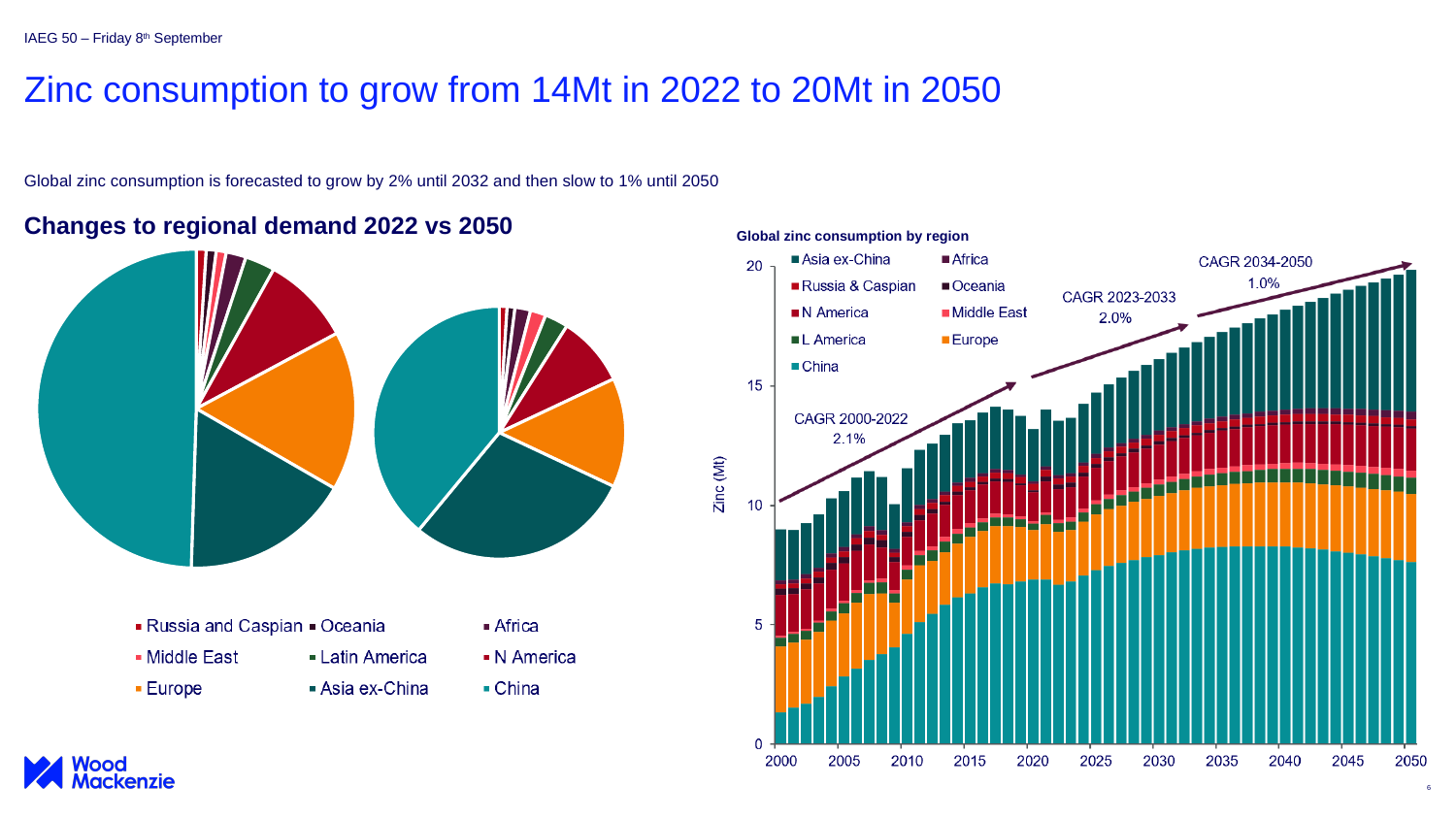
What kind of charts are the two charts under 'Changes to regional demand 2022 vs 2050' on the left of the slide? pie charts What kind of chart is the 'Global zinc consumption by region' chart on the right of the slide? bar chart In the 'Global zinc consumption by region' chart, what CAGR is annotated for 2023-2033? 2.0% In the left-hand (2022) pie chart, which slice is larger: China or Europe? China In the 'Global zinc consumption by region' chart, what CAGR is annotated for 2000-2022? 2.1% In the 'Global zinc consumption by region' chart, what CAGR is annotated for 2034-2050? 1.0% In the left-hand (2022) pie chart under 'Changes to regional demand 2022 vs 2050', which region has the largest slice? China What is the y-axis label of the 'Global zinc consumption by region' chart? Zinc (Mt) How many series does the legend of the 'Global zinc consumption by region' chart list? 9 In the 'Global zinc consumption by region' chart, is the total bar height for 2000 greater or less than 10? less In the 'Global zinc consumption by region' chart, do the total bar heights generally rise or fall from 2000 to 2050? rise In the 'Global zinc consumption by region' chart, is the total bar height for 2030 greater or less than 15? greater